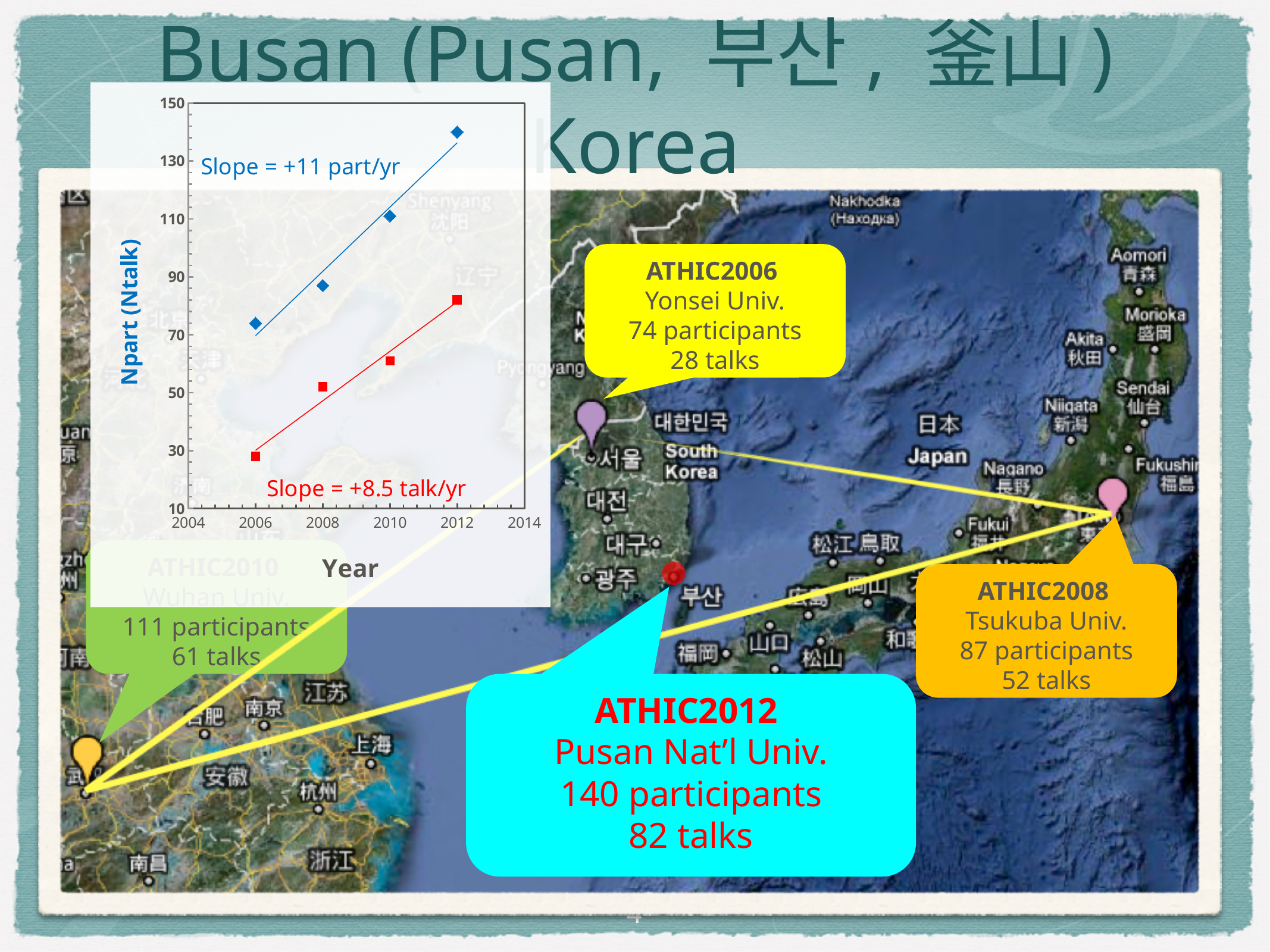
How many data points does each series in the chart have? 4 How many talks does the slide give for ATHIC2008 (the 2008 red point)? 52 talks In 2010, which series has the higher value, participants (blue) or talks (red)? Participants (blue) Is the blue (participants) value for 2012 greater or less than 130? greater How many participants does the slide give for ATHIC2012 (the 2012 blue point)? 140 participants By how much did the number of participants increase from 2006 (74) to 2012 (140)? 66 Is the red (talks) value for 2012 greater or less than 70? greater Do the participant (blue) values rise or fall from 2006 to 2012? Rise Is the blue (participants) value for 2010 greater or less than 90? greater What kind of chart is shown on the slide? Scatter plot with trend lines What slope is given for the participants (blue) trend line? +11 part/yr